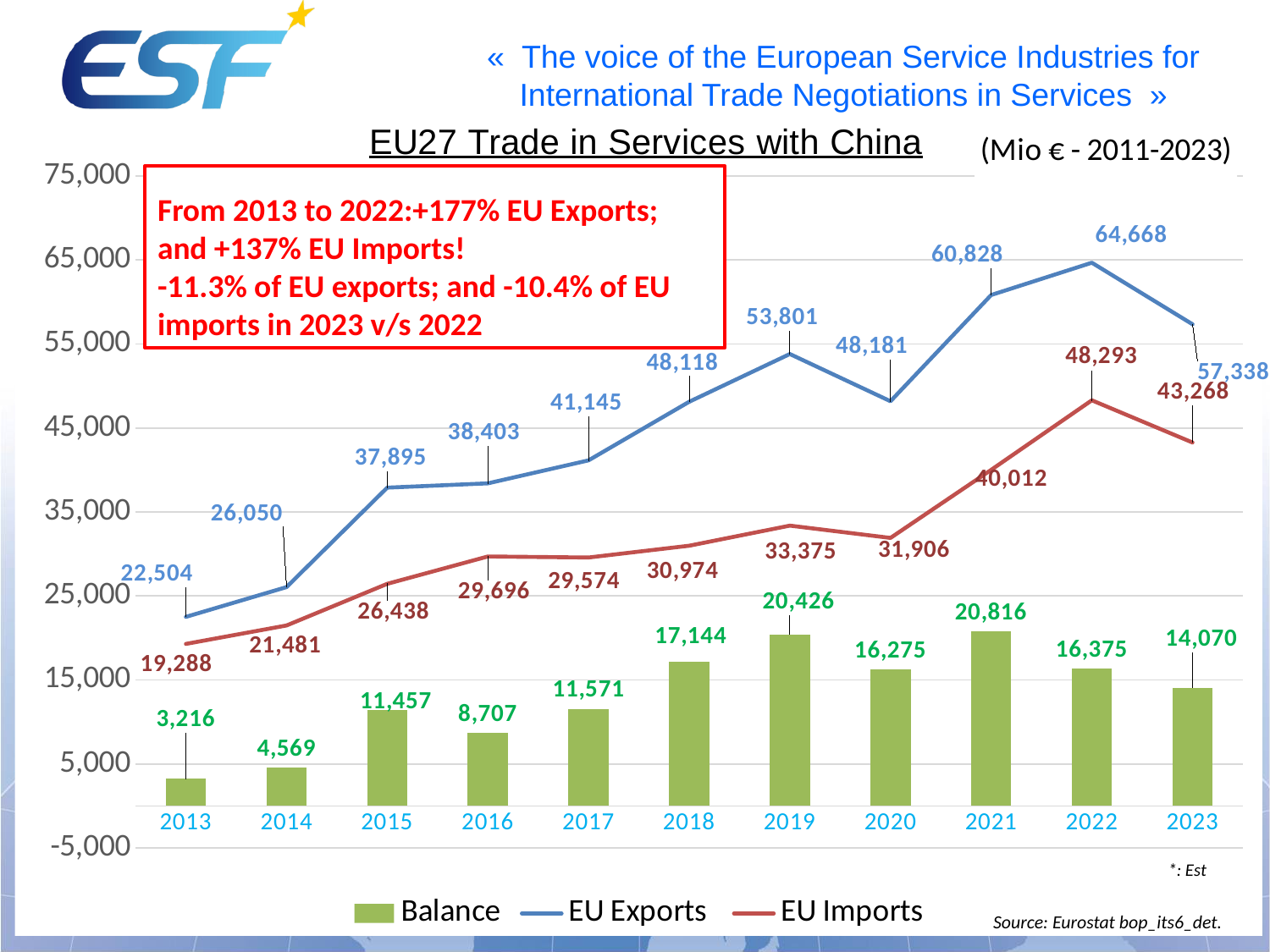
Do EU Imports rise or fall from 2022 to 2023? fall What is the difference between EU Exports and EU Imports in 2023? 14,070 What is the title of the chart? EU27 Trade in Services with China What is the value of EU Imports in 2013? 19,288 In which year is the Balance lowest? 2013 In which year is the Balance highest? 2021 What is the value of EU Exports in 2022? 64,668 How many series does the legend list? 3 Which is larger in 2020: EU Exports or EU Imports? EU Exports What is the Balance value for 2019? 20,426 How many years are shown on the x axis? 11 In which year do EU Exports reach their highest value? 2022